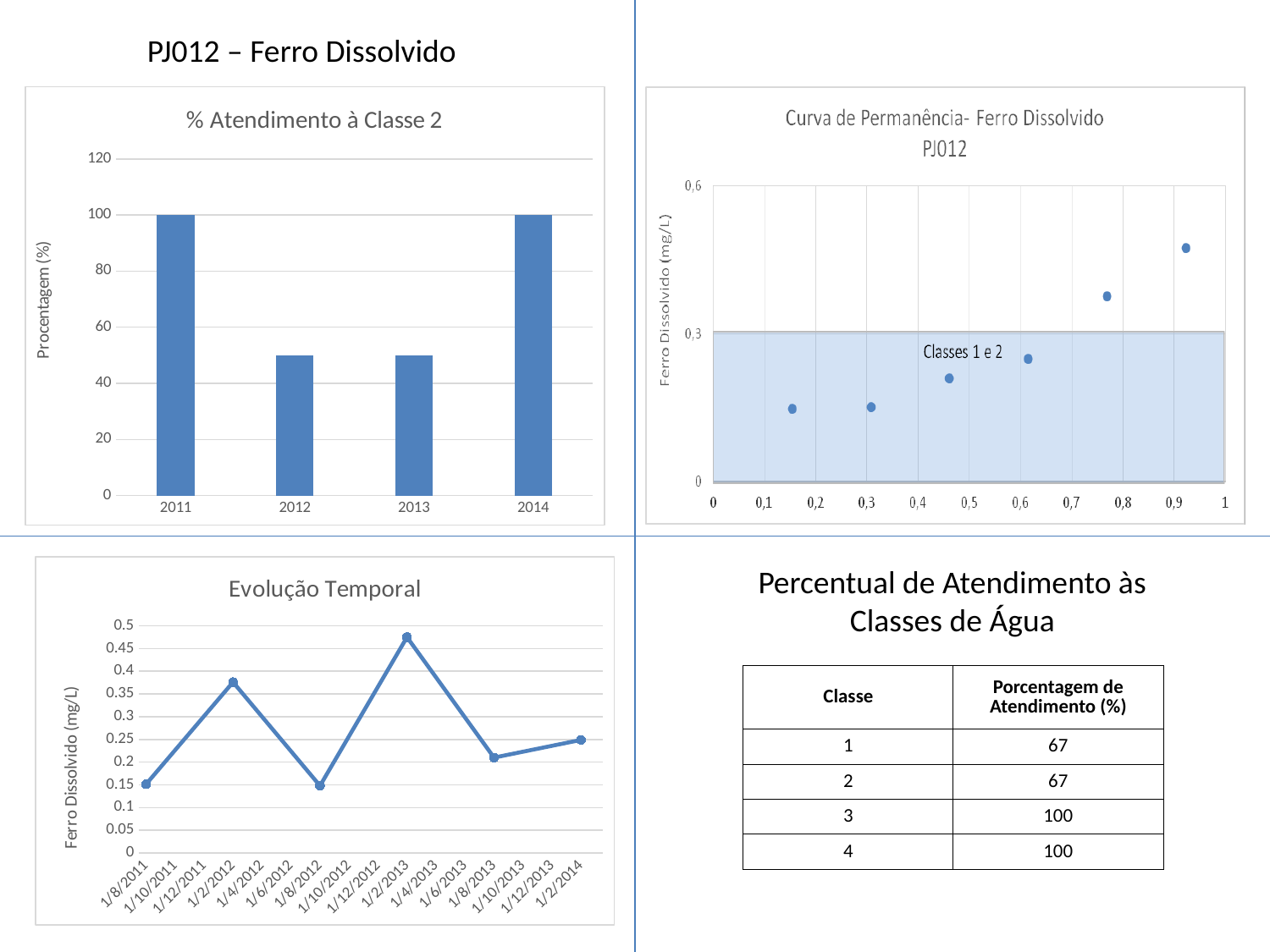
In the chart titled "Curva de Permanência- Ferro Dissolvido PJ012", how many data points are plotted? 6 In the chart titled "Curva de Permanência- Ferro Dissolvido PJ012", is the rightmost point (near 0.9 on the x axis) greater or less than 0,3 mg/L? greater In the chart titled "% Atendimento à Classe 2", is the value for 2013 greater or less than 60? less In the chart titled "Curva de Permanência- Ferro Dissolvido PJ012", what label is shown inside the shaded band below 0,3? Classes 1 e 2 In the chart titled "Evolução Temporal", is the value at 1/2/2012 greater or less than 0.3? greater In the chart titled "% Atendimento à Classe 2", which is larger, the value for 2011 or the value for 2012? 2011 In the chart titled "% Atendimento à Classe 2", what is the value for 2014? 100 What kind of chart is the one titled "% Atendimento à Classe 2"? bar chart In the chart titled "% Atendimento à Classe 2", how many years are shown on the x axis? 4 In the chart titled "% Atendimento à Classe 2", what is the value for 2011? 100